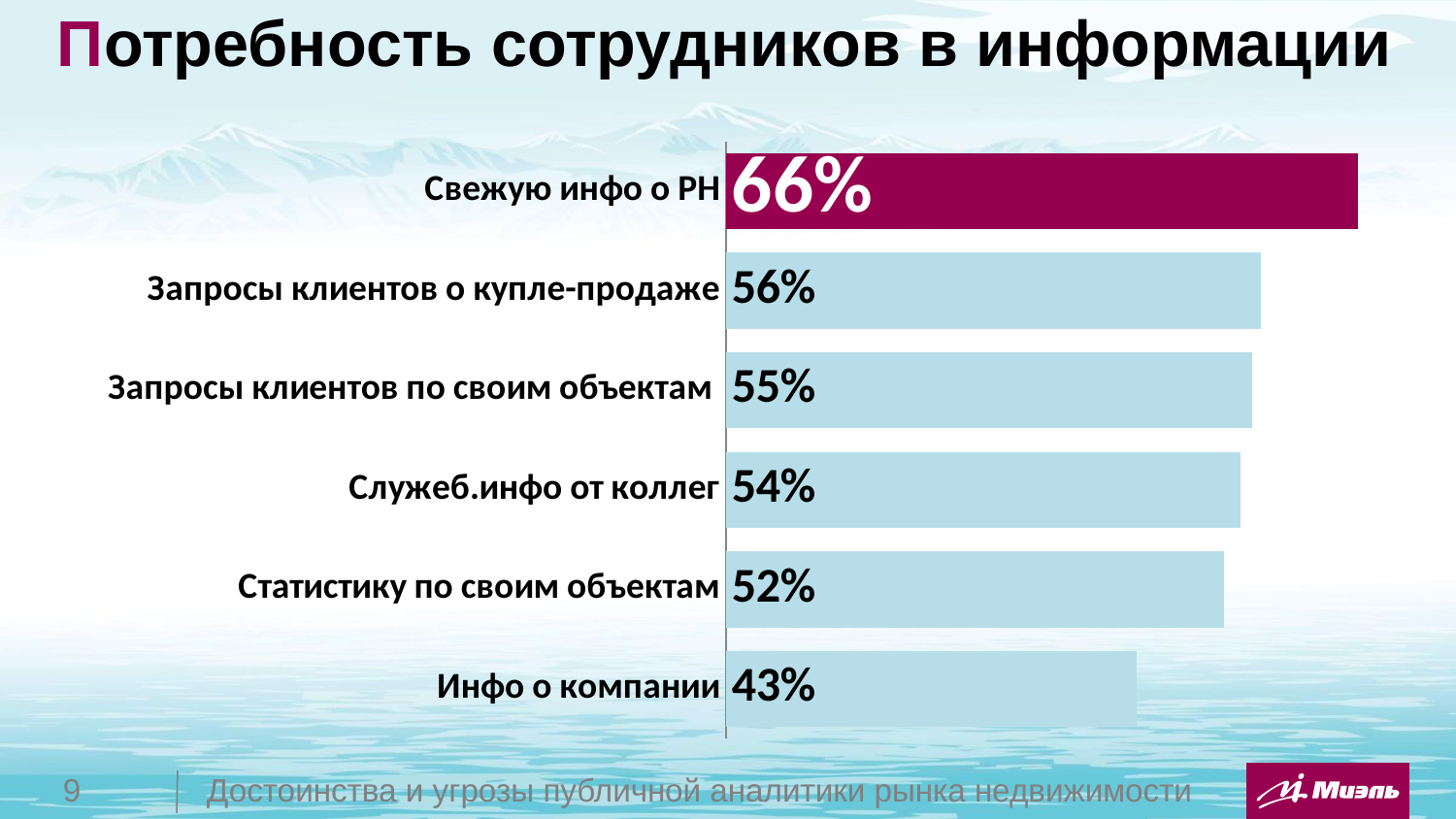
Which is larger: the value for "Запросы клиентов о купле-продаже" or the value for "Статистику по своим объектам"? Запросы клиентов о купле-продаже What is the value for "Свежую инфо о РН"? 66% What is the value for "Служеб.инфо от коллег"? 54% What is the difference between the values for "Запросы клиентов о купле-продаже" and "Статистику по своим объектам"? 4% What is the value for "Инфо о компании"? 43% How many categories are shown in the chart? 6 What is the title of the slide? Потребность сотрудников в информации Which category has the lowest value? Инфо о компании What is the difference between the values for "Свежую инфо о РН" and "Инфо о компании"? 23% What kind of chart is shown on the slide? Bar chart Which bar is shown in a different colour from the others? Свежую инфо о РН Which category has the highest value? Свежую инфо о РН